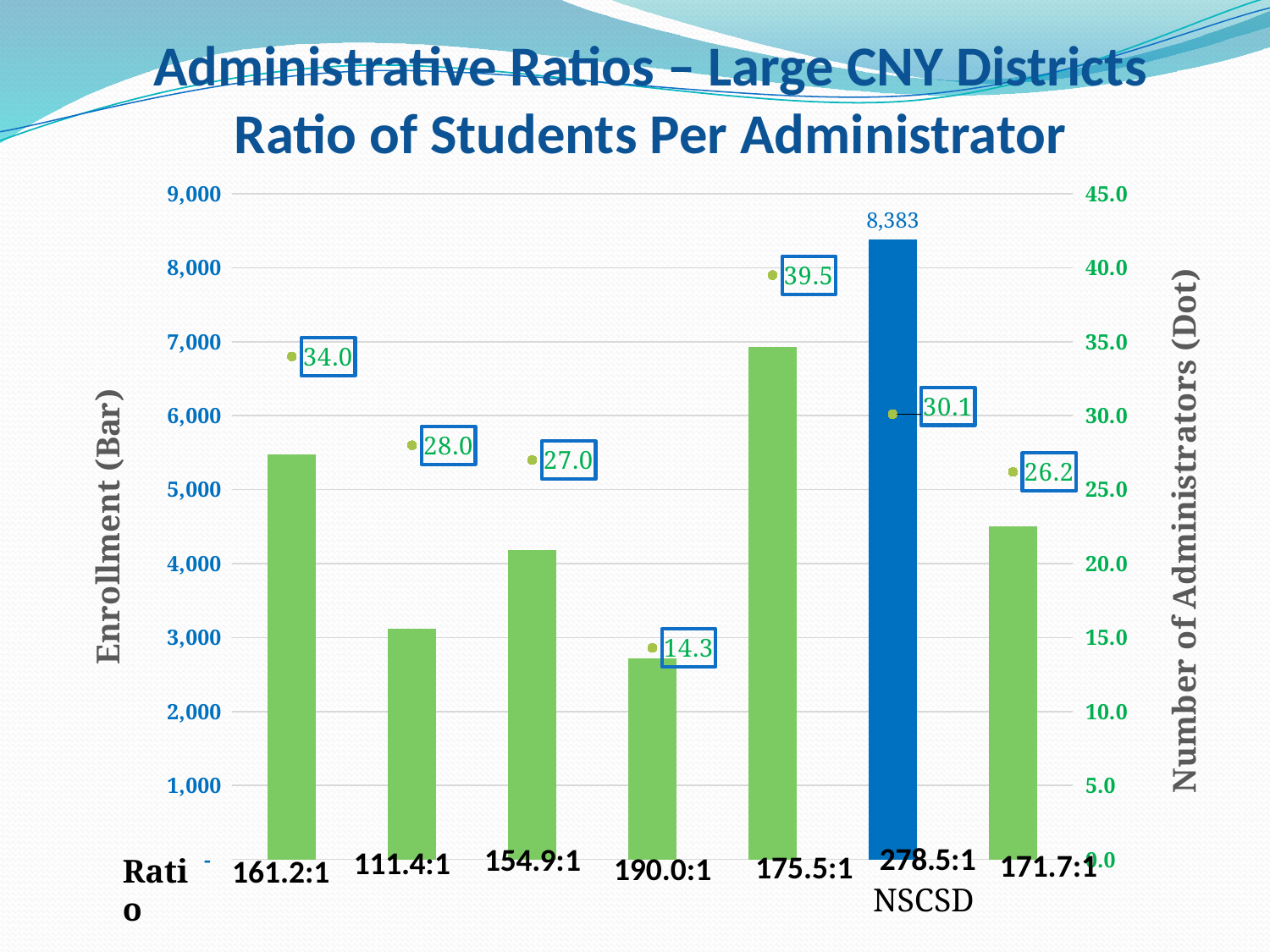
What does the right-hand vertical axis represent? Number of Administrators (Dot) Is the enrollment bar for the district with ratio 175.5:1 greater or less than 6,000? greater What is the difference in number of administrators between the district with ratio 175.5:1 and the district with ratio 190.0:1? 25.2 What is the number of administrators (dot) for NSCSD? 30.1 Which district has the highest number of administrators (dot)? 175.5:1 (39.5) What is the enrollment shown for NSCSD? 8,383 How many districts (bars) are shown in the chart? 7 What is the number of administrators (dot) for the district with ratio 190.0:1? 14.3 Is the enrollment bar for the district with ratio 111.4:1 greater or less than 4,000? less Which district has the lowest number of administrators (dot)? 190.0:1 (14.3) Which has more administrators: the district with ratio 111.4:1 or the district with ratio 154.9:1? 111.4:1 What is the number of administrators (dot) for the district with ratio 161.2:1? 34.0